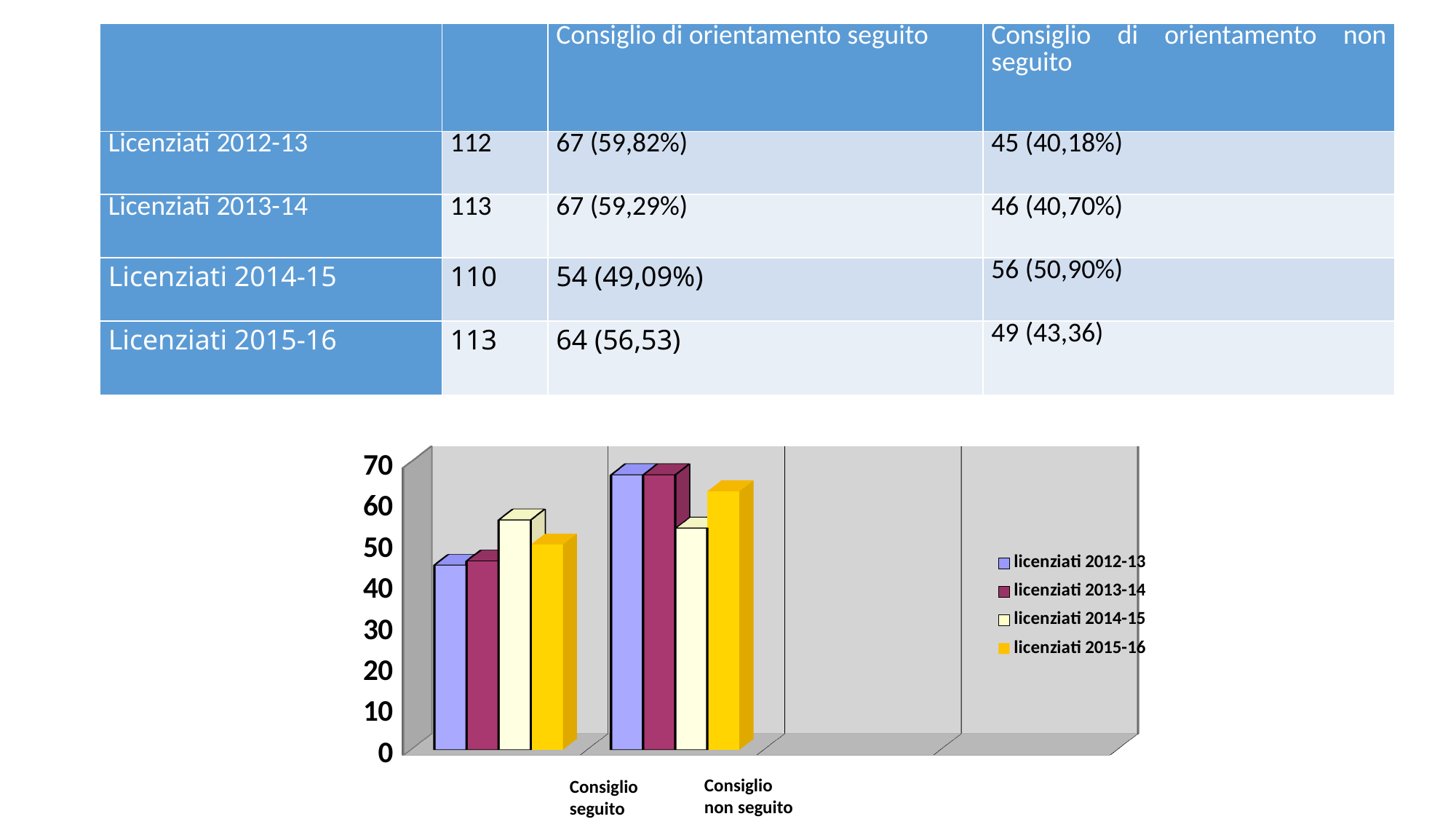
How many series does the chart's legend list? 4 What kind of chart is shown on the slide? bar chart In the left group of bars, is the value for licenziati 2012-13 greater or less than 50? less In the left group of bars, which series has the highest bar? licenziati 2014-15 Which colour is used for the licenziati 2015-16 series in the chart? yellow In the right group of bars, is the value for licenziati 2014-15 greater or less than 60? less In the right group of bars, is the value for licenziati 2012-13 greater or less than 60? greater How many groups of bars are plotted on the chart? 2 In the right group of bars, which series has the lowest bar? licenziati 2014-15